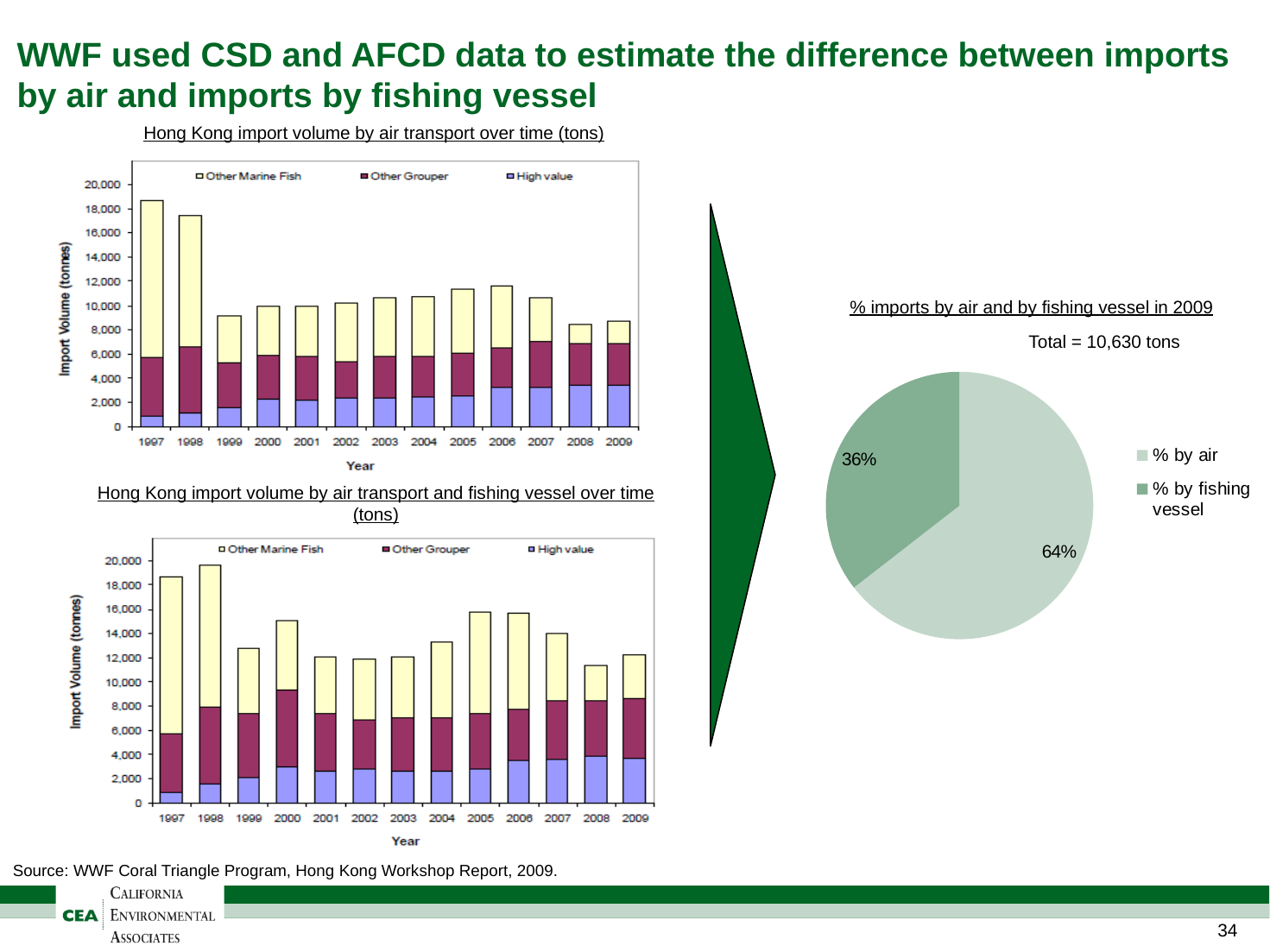
In the pie chart '% imports by air and by fishing vessel in 2009', which category has the larger share? % by air In the pie chart '% imports by air and by fishing vessel in 2009', what percentage of imports is by air? 64% What kind of chart is 'Hong Kong import volume by air transport over time (tons)'? Stacked bar chart In the pie chart '% imports by air and by fishing vessel in 2009', how many slices does the pie have? 2 In the pie chart '% imports by air and by fishing vessel in 2009', what percentage of imports is by fishing vessel? 36% In the chart 'Hong Kong import volume by air transport over time (tons)', which year has the highest total import volume? 1997 In the chart 'Hong Kong import volume by air transport and fishing vessel over time (tons)', is the total import volume for 2005 greater or less than 14,000? greater In the pie chart '% imports by air and by fishing vessel in 2009', what total volume in tons is stated above the pie? 10,630 tons In the chart 'Hong Kong import volume by air transport over time (tons)', how many years are shown on the x axis? 13 In the chart 'Hong Kong import volume by air transport over time (tons)', is the total import volume for 1999 greater or less than 10,000? less In the chart 'Hong Kong import volume by air transport and fishing vessel over time (tons)', which year has the highest total import volume? 1998 In the chart 'Hong Kong import volume by air transport over time (tons)', how many series does the legend list? 3